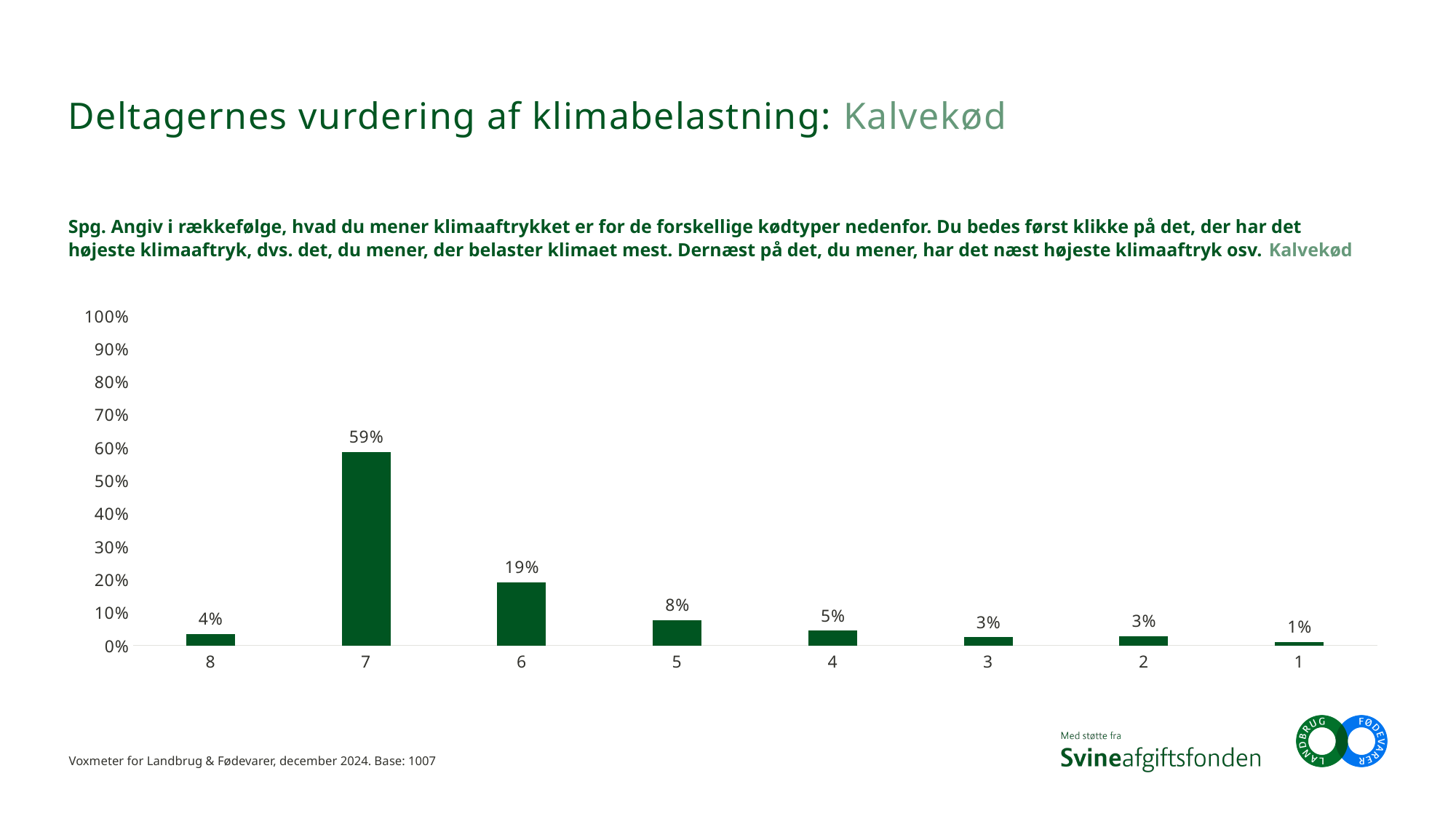
What is the value for category 1? 1% What is the value for category 8? 4% Is the value for category 7 greater or less than 50%? greater Which category has the highest value? 7 Which category has the lowest value? 1 Which is larger, the value for category 5 or the value for category 4? 5 What is the value for category 7? 59% What kind of chart is shown on the slide? bar chart What is the difference between the values for category 7 and category 6? 40% What is the value for category 6? 19% How many categories are shown on the x axis? 8 What is the title of the slide? Deltagernes vurdering af klimabelastning: Kalvekød